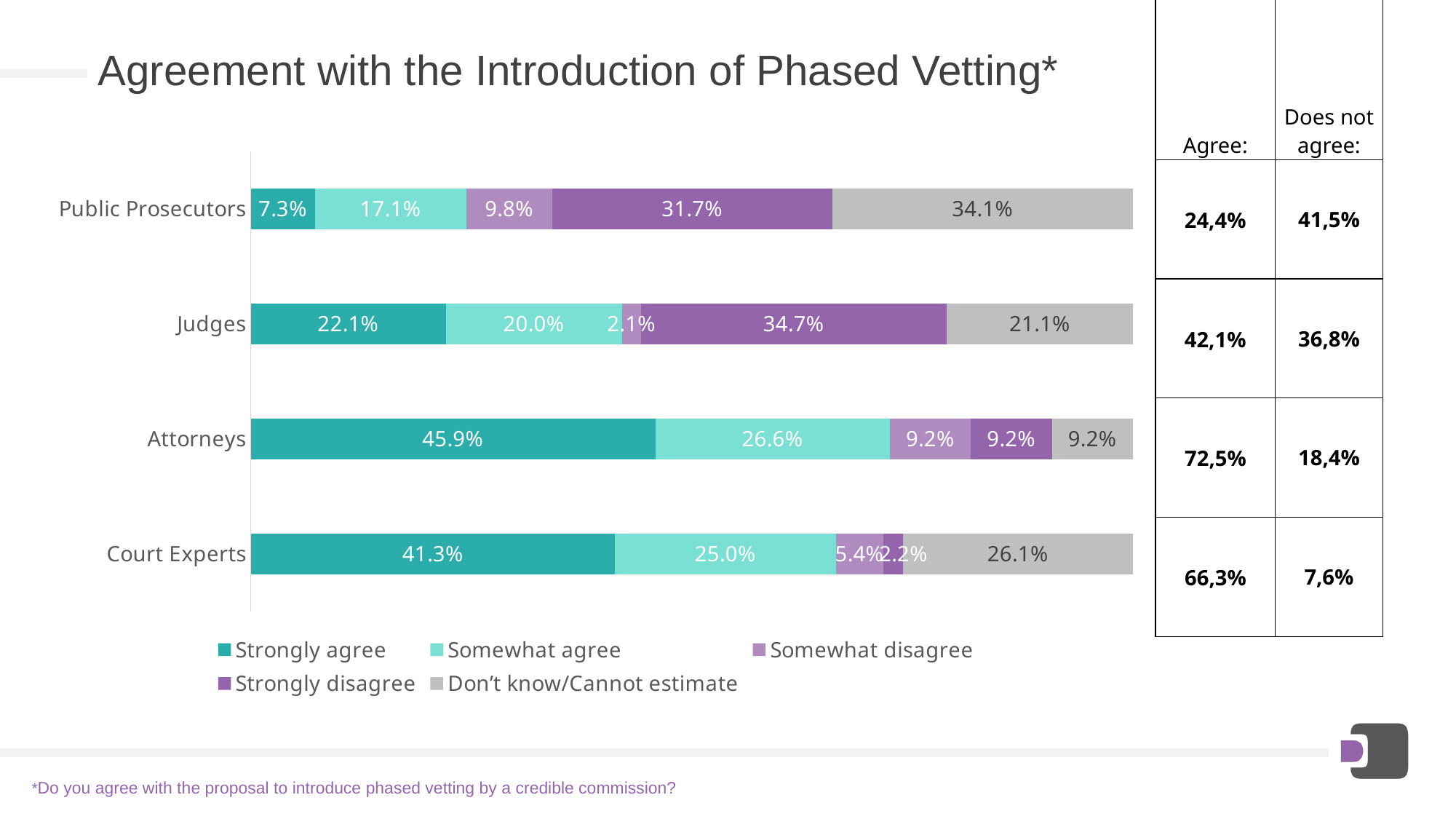
How many groups are shown on the chart? 4 Which group has a larger 'Somewhat agree' share, Judges or Public Prosecutors? Judges How many percentage points higher is the 'Strongly agree' value for Attorneys than for Court Experts? 4.6 percentage points Which group has the lowest 'Strongly disagree' share? Court Experts What percentage of Attorneys strongly agree with the introduction of phased vetting? 45.9% What is the 'Don't know/Cannot estimate' value for Public Prosecutors? 34.1% What is the 'Somewhat disagree' value for Judges? 2.1% What is the difference between the 'Strongly disagree' values for Judges and Public Prosecutors? 3.0 percentage points What type of chart is shown on the slide? Stacked bar chart Which group has the highest 'Strongly agree' share? Attorneys What is the title of the chart? Agreement with the Introduction of Phased Vetting* How many series does the legend list? 5